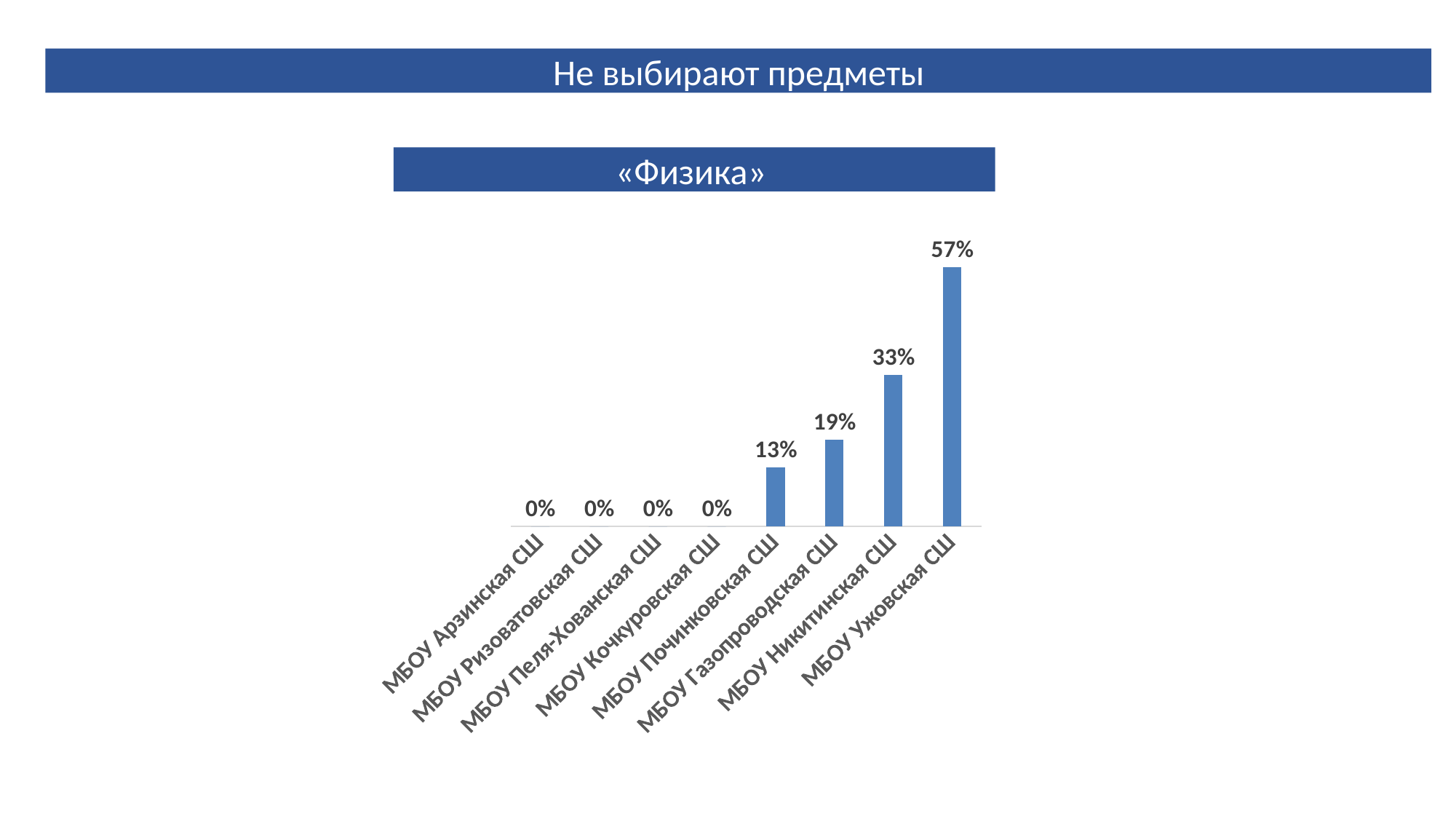
What is the difference between the values for МБОУ Газопроводская СШ and МБОУ Починковская СШ? 6% What is the difference between the values for МБОУ Ужовская СШ and МБОУ Никитинская СШ? 24% What is the value for МБОУ Арзинская СШ? 0% Which school has the highest value? МБОУ Ужовская СШ What is the value for МБОУ Ужовская СШ? 57% What is the value for МБОУ Газопроводская СШ? 19% What is the value for МБОУ Никитинская СШ? 33% How many schools are shown on the x axis? 8 What kind of chart is shown? Bar chart What is the value for МБОУ Починковская СШ? 13% Do the values rise or fall from left to right along the x axis? Rise Which is larger, the value for МБОУ Никитинская СШ or МБОУ Газопроводская СШ? МБОУ Никитинская СШ